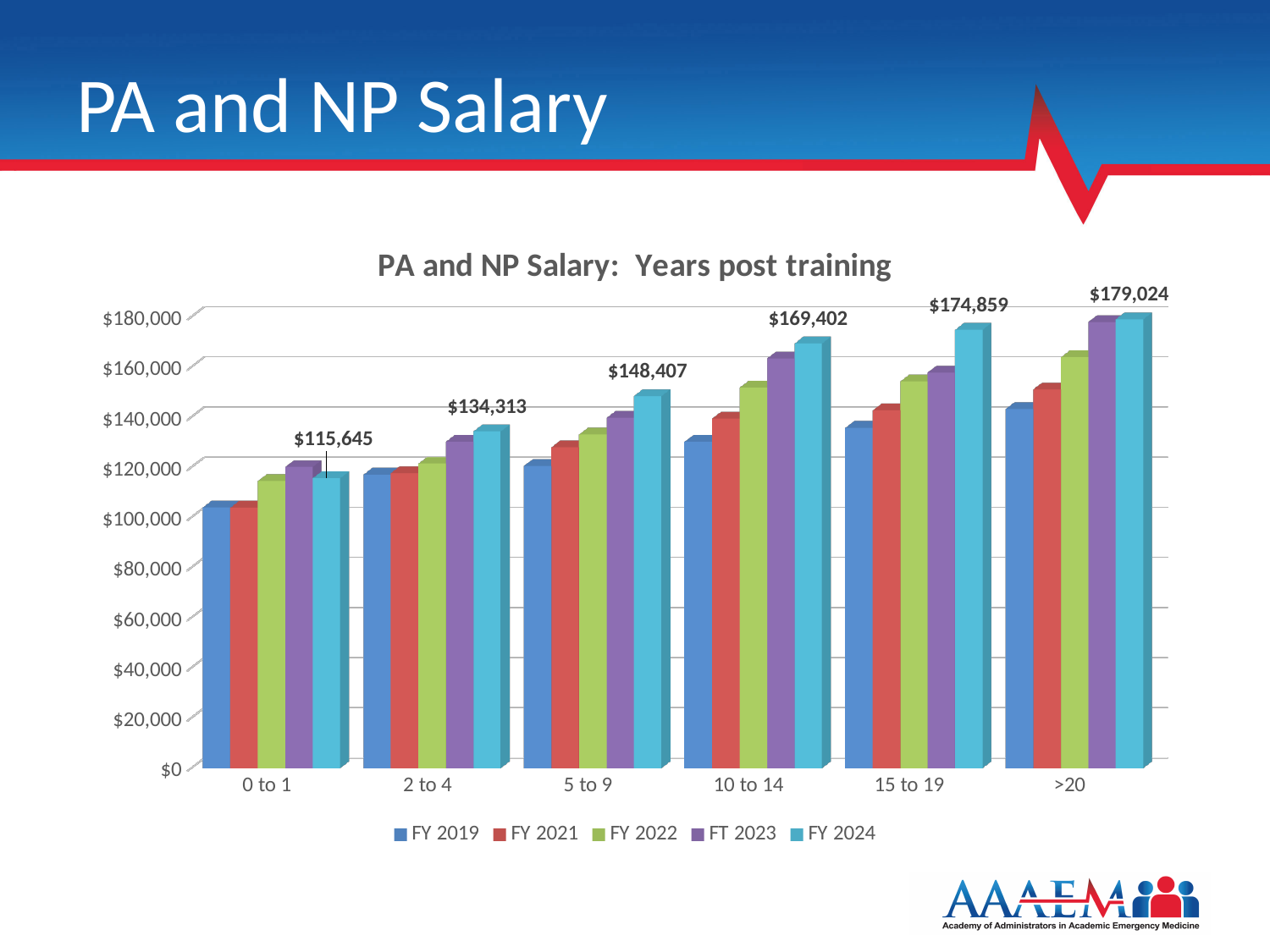
Which years-post-training group has the highest FY 2024 salary? >20 How many series does the legend list? 5 What is the FY 2024 salary for the >20 years post training group? $179,024 How many years-post-training categories are shown on the x axis? 6 Do the FY 2024 salaries rise or fall as years post training increase along the x axis? rise What is the difference between the FY 2024 salary for >20 years and for 0 to 1 years post training? $63,379 What is the FY 2024 salary for the 10 to 14 years post training group? $169,402 Which years-post-training group has the lowest FY 2024 salary? 0 to 1 What is the FY 2024 salary for the 0 to 1 years post training group? $115,645 Is the FY 2019 salary for the 0 to 1 years group greater or less than $120,000? less Which has the larger FY 2024 salary: 5 to 9 years or 2 to 4 years post training? 5 to 9 What is the difference between the FY 2024 salary for 15 to 19 years and for 10 to 14 years post training? $5,457